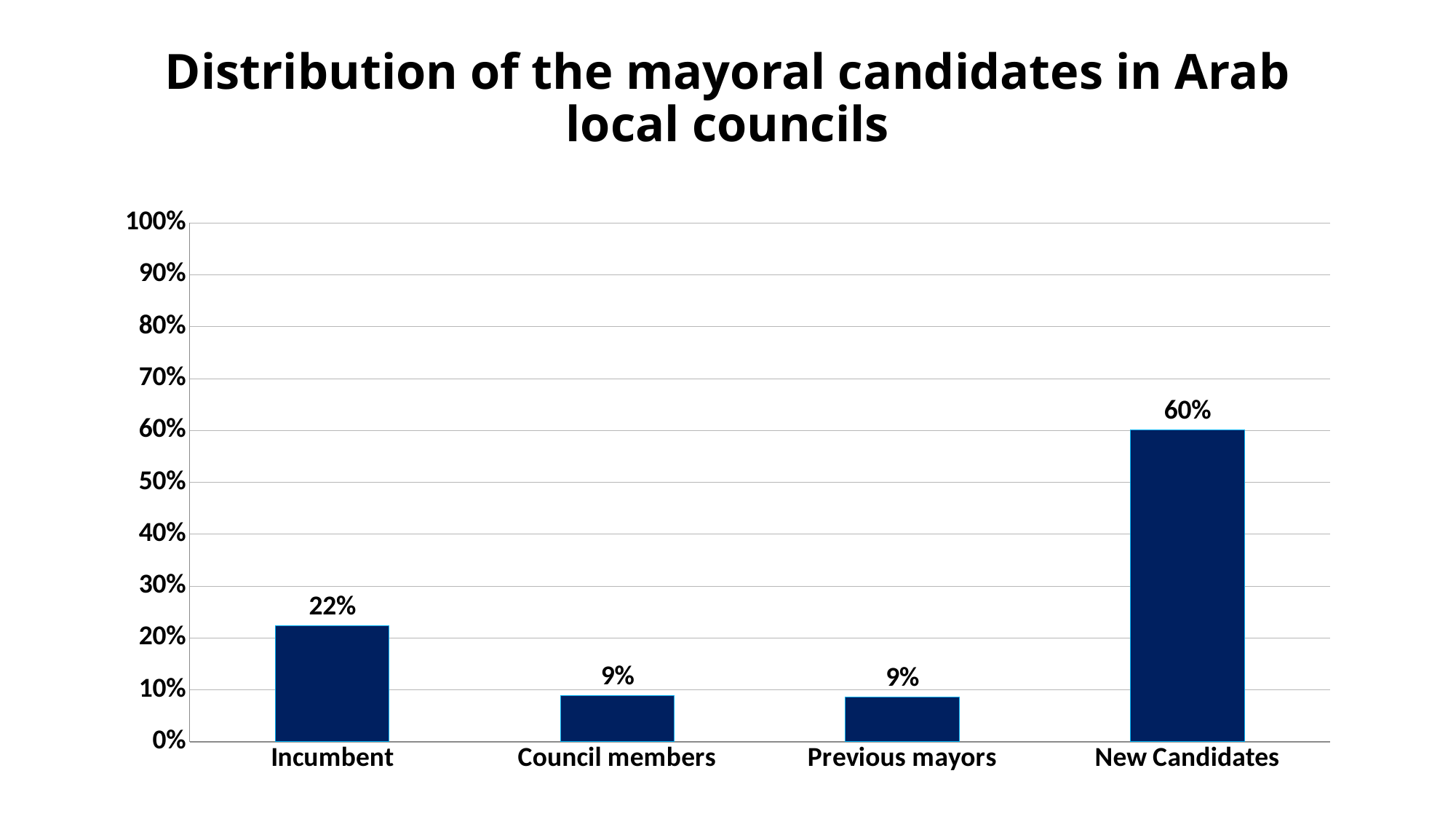
What is the value for New Candidates? 60% Which category has the highest value? New Candidates What kind of chart is shown on the slide? Bar chart Which is larger, the value for Incumbent or the value for Previous mayors? Incumbent What is the title of the chart? Distribution of the mayoral candidates in Arab local councils Is the value for New Candidates greater or less than 50%? greater What is the value for Council members? 9% What is the difference between the values for New Candidates and Incumbent? 38% How many categories are shown on the x axis? 4 What is the value for Incumbent? 22% What is the value for Previous mayors? 9% What is the difference between the values for Incumbent and Council members? 13%